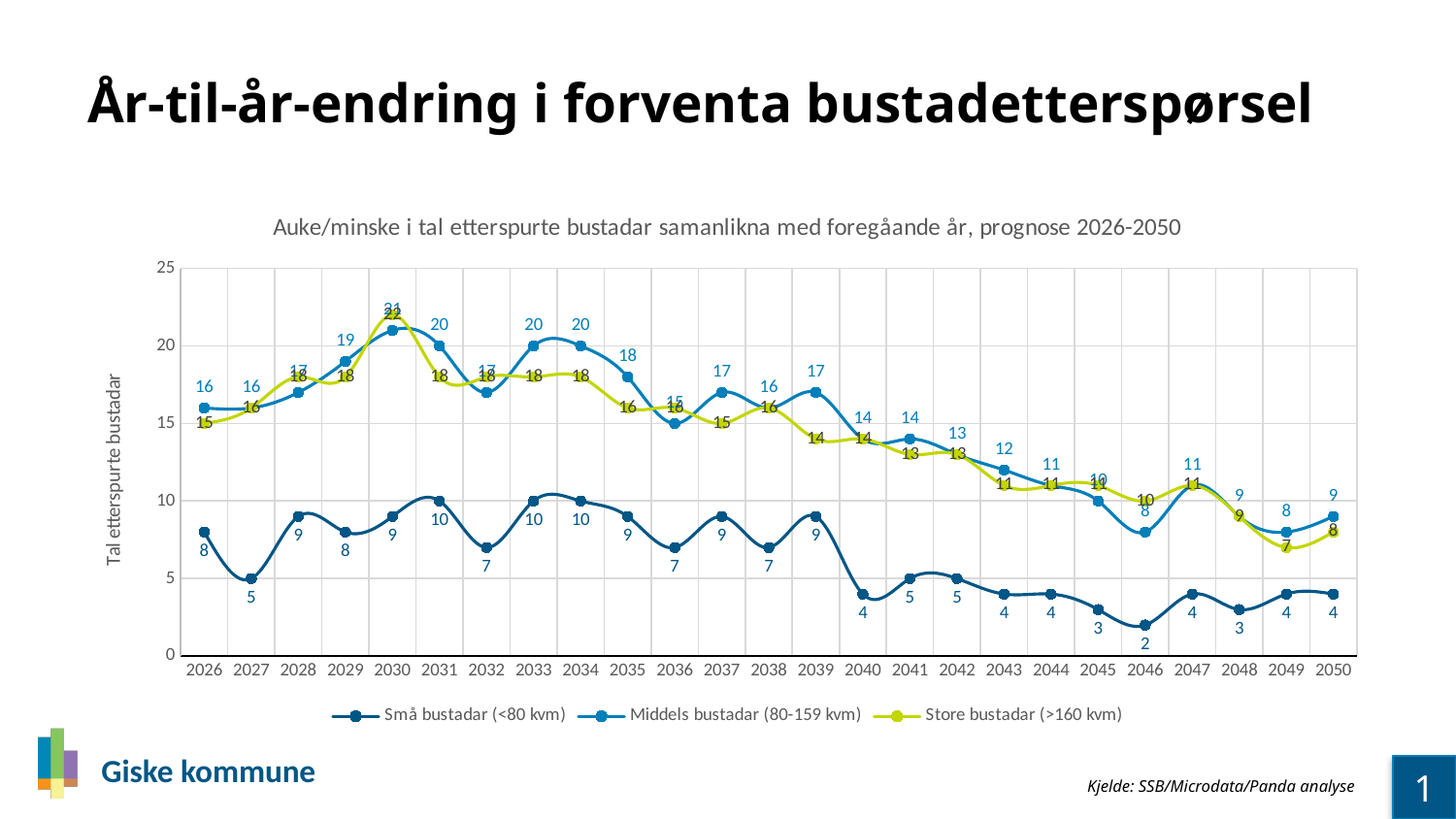
How many series does the legend list? 3 In 2037, which is larger: Middels bustadar (80-159 kvm) or Store bustadar (>160 kvm)? Middels bustadar (80-159 kvm) What is the value for Små bustadar (<80 kvm) in 2027? 5 What is the difference between the Små bustadar (<80 kvm) values for 2026 and 2027? 3 In which year is the value for Små bustadar (<80 kvm) lowest? 2046 What is the label on the vertical axis? Tal etterspurte bustadar What kind of chart is shown on the slide? line chart In which year is the value for Middels bustadar (80-159 kvm) highest? 2030 What is the value for Middels bustadar (80-159 kvm) in 2033? 20 Is the value for Middels bustadar (80-159 kvm) in 2029 greater or less than 15? greater How many years are plotted along the x axis? 25 What is the value for Store bustadar (>160 kvm) in 2049? 7